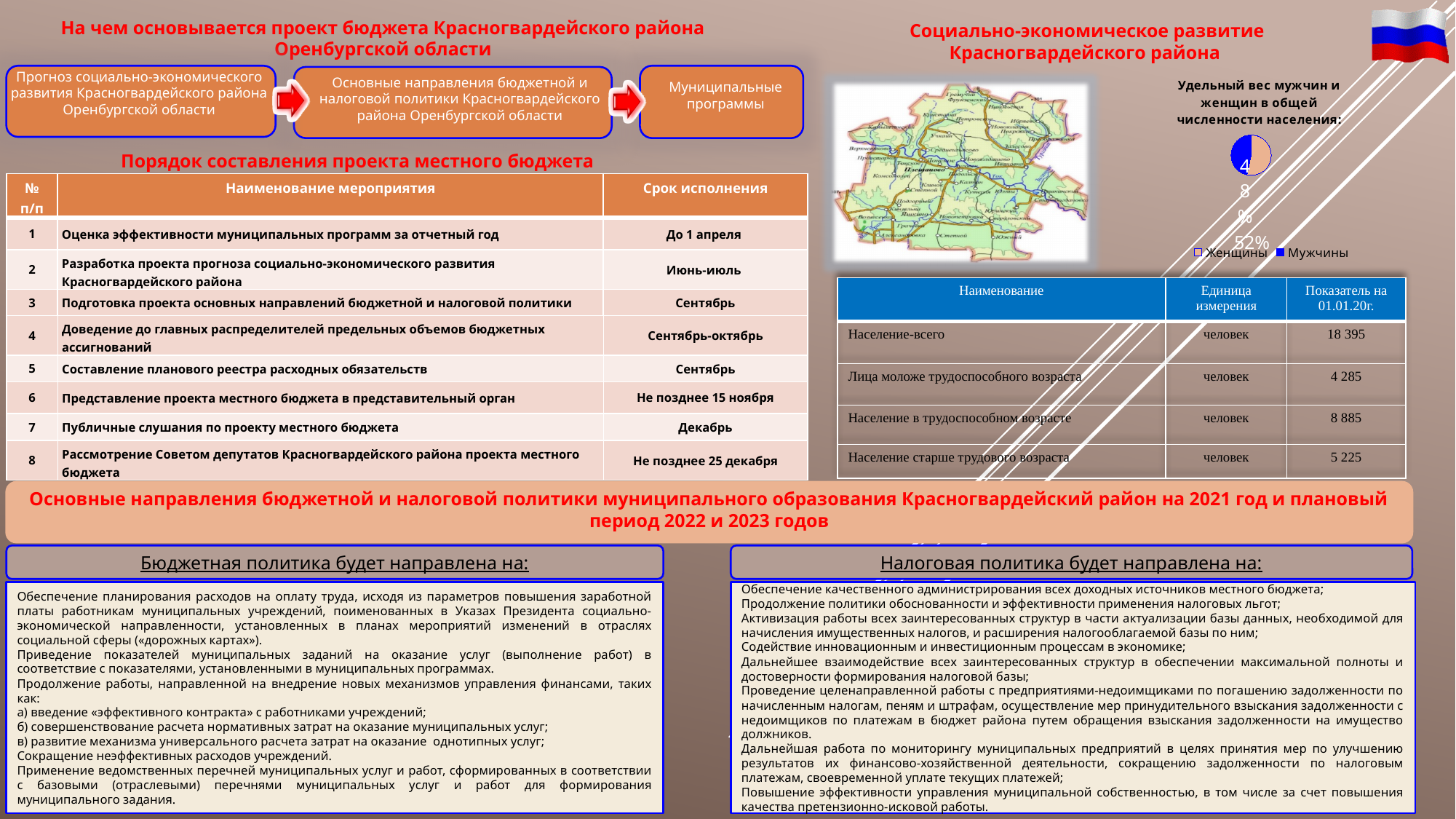
How many slices does the pie chart have? 2 What two percentage values are labelled on the pie chart? 48% and 52% Which legend entry of the pie chart is shown in blue? Мужчины What are the two legend entries of the pie chart? Женщины, Мужчины What kind of chart is shown under the heading 'Удельный вес мужчин и женщин в общей численности населения'? pie chart How many series does the legend of the pie chart list? 2